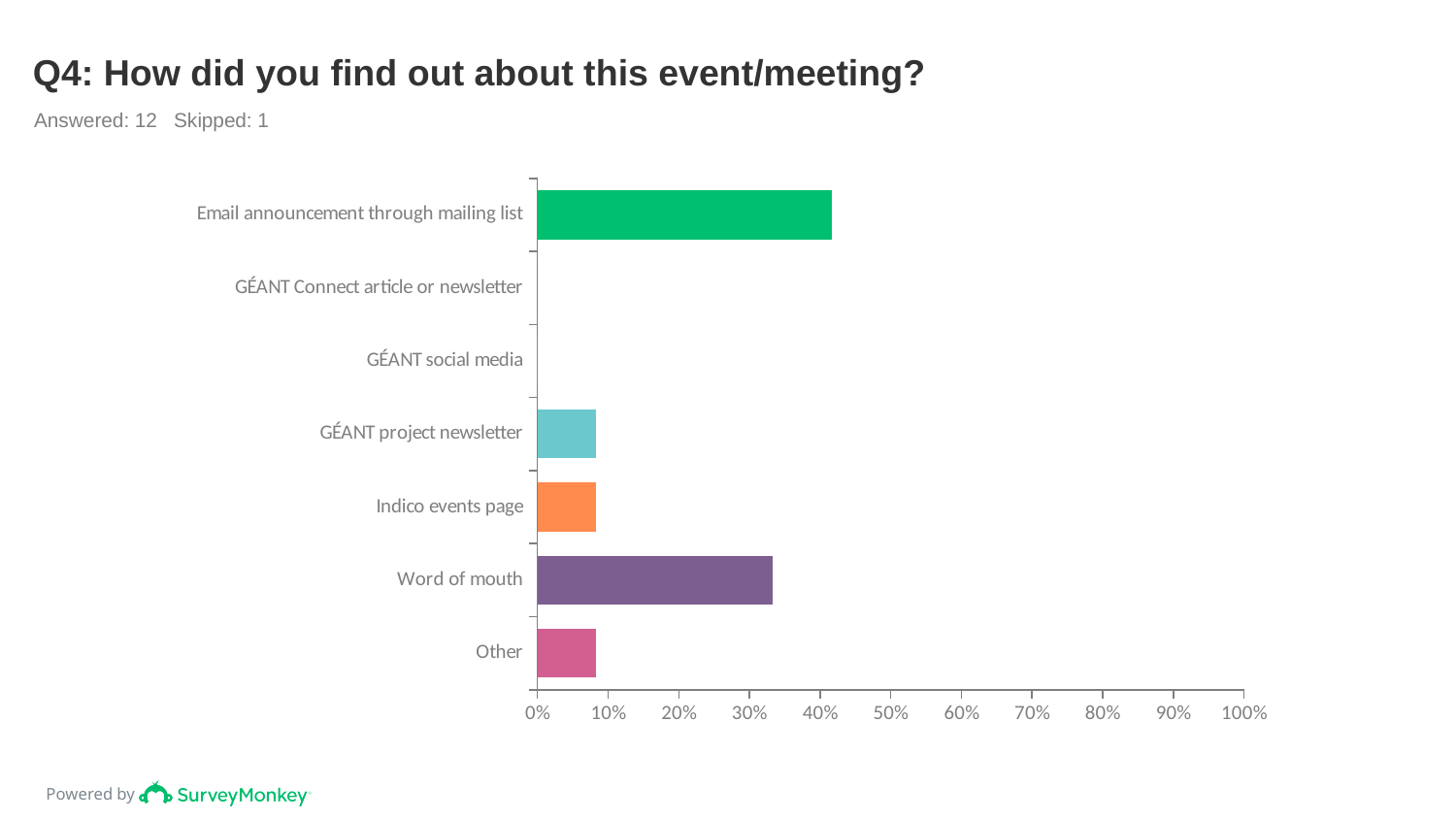
Which is larger, the value for Word of mouth or the value for GÉANT project newsletter? Word of mouth What kind of chart is shown on the slide? bar chart Is the value for Indico events page greater or less than 10%? less Is the value for Word of mouth greater or less than 40%? less What is the title of the chart? Q4: How did you find out about this event/meeting? How many categories are shown on the chart? 7 Is the value for Word of mouth greater or less than 30%? greater How many respondents answered the question according to the slide? 12 Which category has the highest value? Email announcement through mailing list Which is larger, the value for Email announcement through mailing list or the value for Word of mouth? Email announcement through mailing list